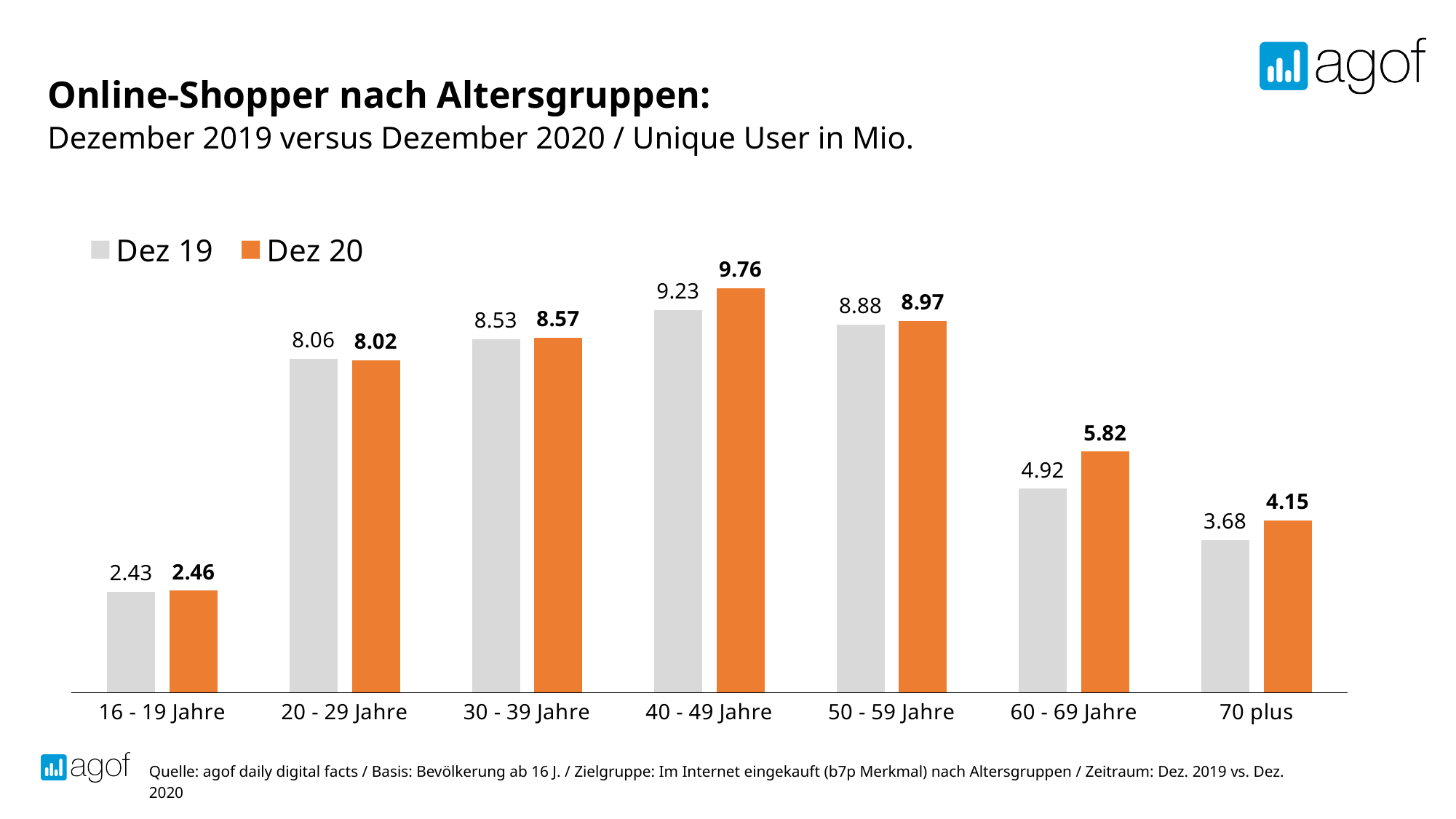
What kind of chart is shown on the slide? Bar chart Which age group has the highest Dez 20 value? 40 - 49 Jahre What is the difference between the Dez 20 and Dez 19 values for the 60 - 69 Jahre age group? 0.90 How many age groups are shown on the x axis? 7 How many series does the legend list? 2 Which colour represents the Dez 20 series? Orange For the 20 - 29 Jahre age group, which is larger: the Dez 19 value or the Dez 20 value? Dez 19 Which age group has the lowest Dez 19 value? 16 - 19 Jahre What is the difference between the Dez 19 and Dez 20 values for the 20 - 29 Jahre age group? 0.04 What is the Dez 19 value for the 60 - 69 Jahre age group? 4.92 What is the Dez 20 value for the 40 - 49 Jahre age group? 9.76 What is the Dez 20 value for 70 plus? 4.15